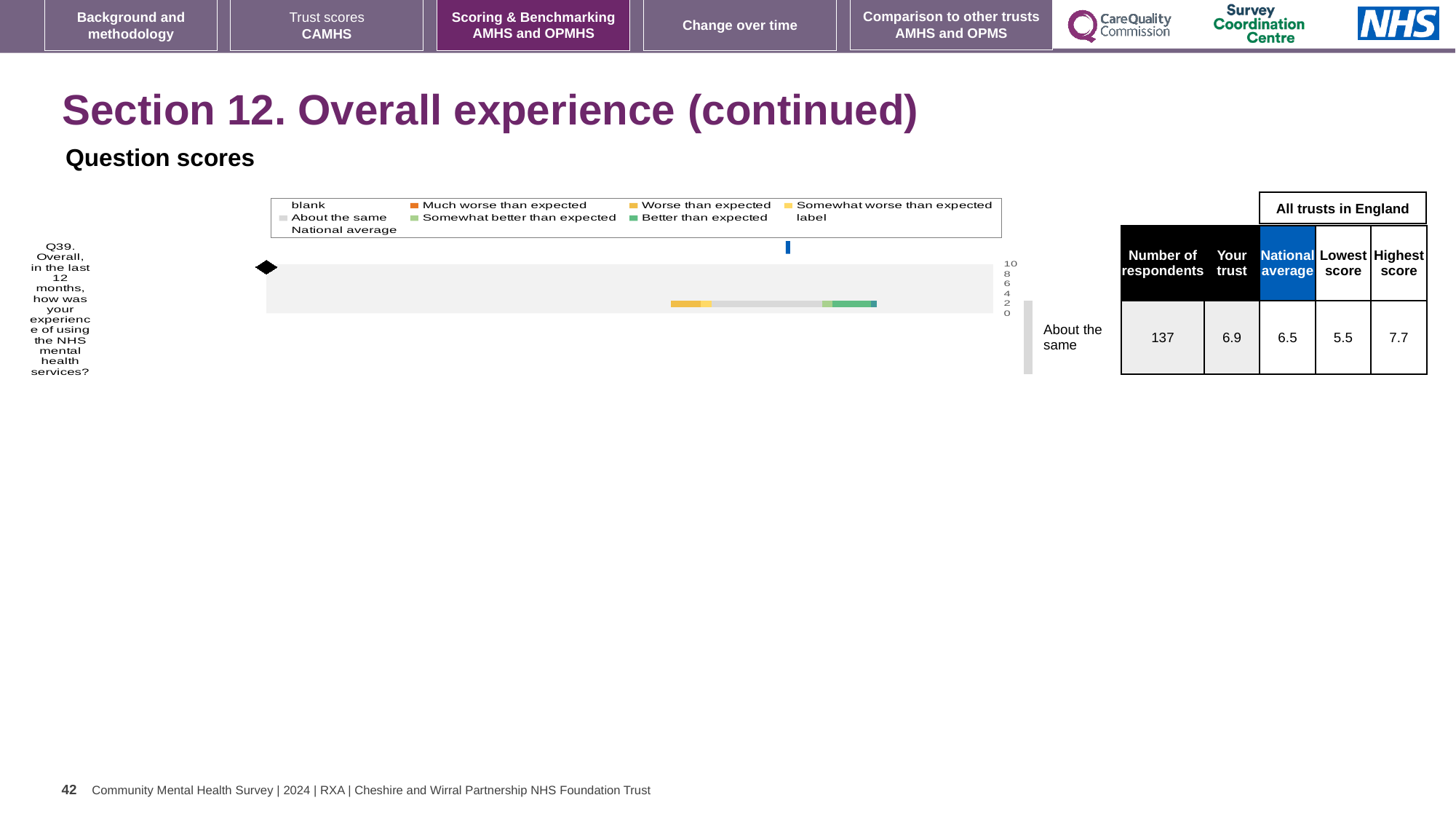
What is the lowest score among all trusts in England for Q39? 5.5 What is the 'Your trust' score for Q39? 6.9 What is the highest score among all trusts in England for Q39? 7.7 Which is larger for Q39, the 'Your trust' score or the national average? Your trust What is the difference between the highest score and the lowest score for Q39? 2.2 What kind of chart is shown on the slide? bar chart How many respondents answered Q39? 137 Which question number is plotted in the chart? Q39 What is the national average score for Q39? 6.5 How many survey questions are plotted in the chart? 1 How many entries does the chart legend list? 9 Which benchmark category is the trust's Q39 result placed in? About the same